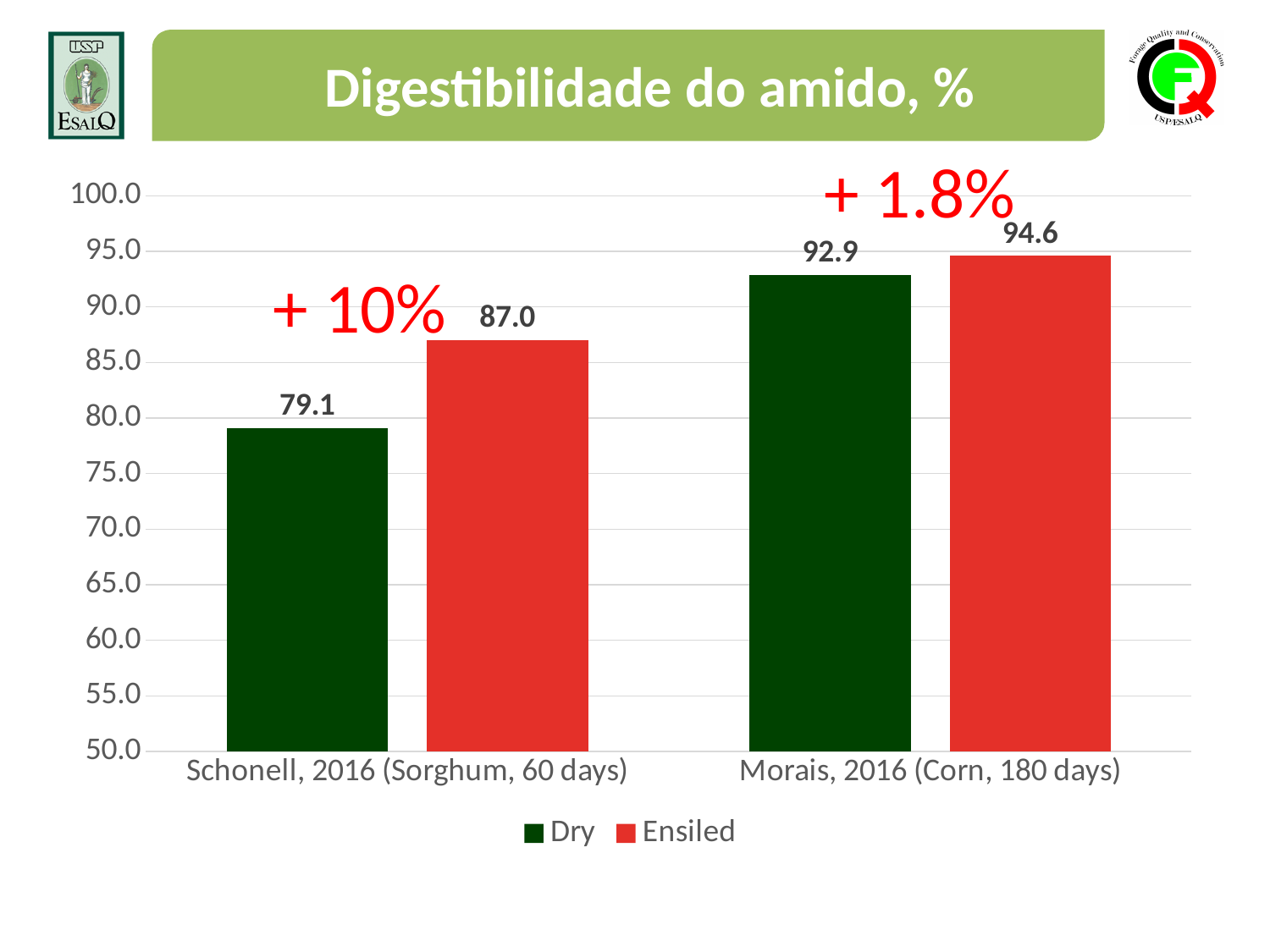
What is the Ensiled value for Schonell, 2016 (Sorghum, 60 days)? 87.0 What is the title of the chart? Digestibilidade do amido, % What is the Ensiled value for Morais, 2016 (Corn, 180 days)? 94.6 What is the Dry value for Schonell, 2016 (Sorghum, 60 days)? 79.1 Which is larger for Morais, 2016 (Corn, 180 days): the Dry value or the Ensiled value? Ensiled How many series does the legend list? 2 What is the difference between the Ensiled and Dry values for Schonell, 2016 (Sorghum, 60 days)? 7.9 Is the Dry value for Schonell, 2016 (Sorghum, 60 days) greater or less than 80.0? less What kind of chart is shown on the slide? bar chart How many categories are shown on the x axis? 2 Which bar has the highest value on the chart? Ensiled, Morais, 2016 (Corn, 180 days) Which bar has the lowest value on the chart? Dry, Schonell, 2016 (Sorghum, 60 days)